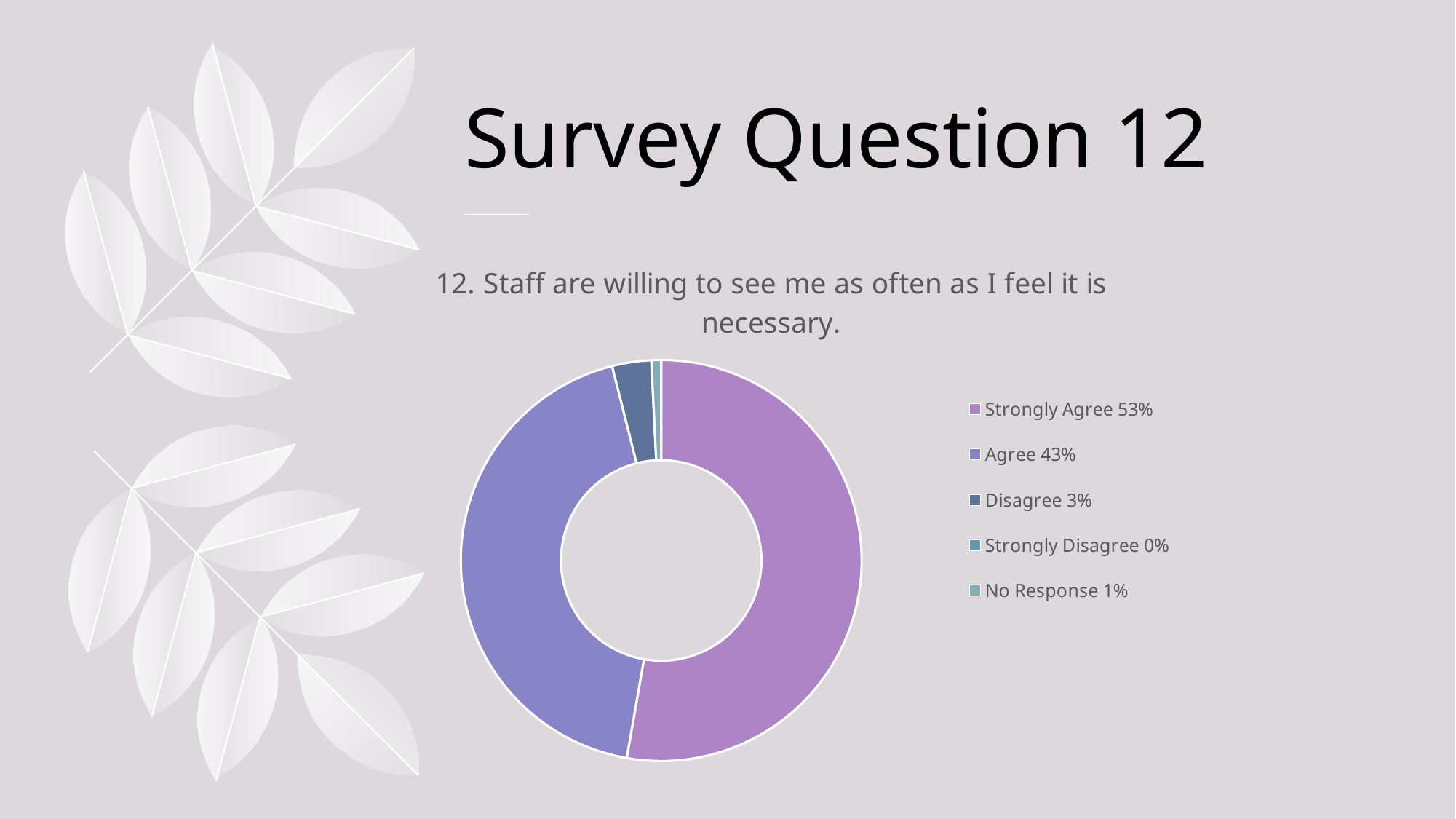
What kind of chart is shown on the slide? Doughnut chart What percentage of respondents gave No Response? 1% How many response categories does the legend list? 5 What is the chart's title? 12. Staff are willing to see me as often as I feel it is necessary. Which is larger, the share for Disagree or the share for No Response? Disagree Which response category has the largest share? Strongly Agree Which response category has the smallest share? Strongly Disagree What percentage of respondents answered Agree? 43% What percentage of respondents answered Disagree? 3% What percentage of respondents answered Strongly Agree? 53% What is the difference in percentage points between Strongly Agree and Agree? 10 What percentage of respondents answered Strongly Disagree? 0%